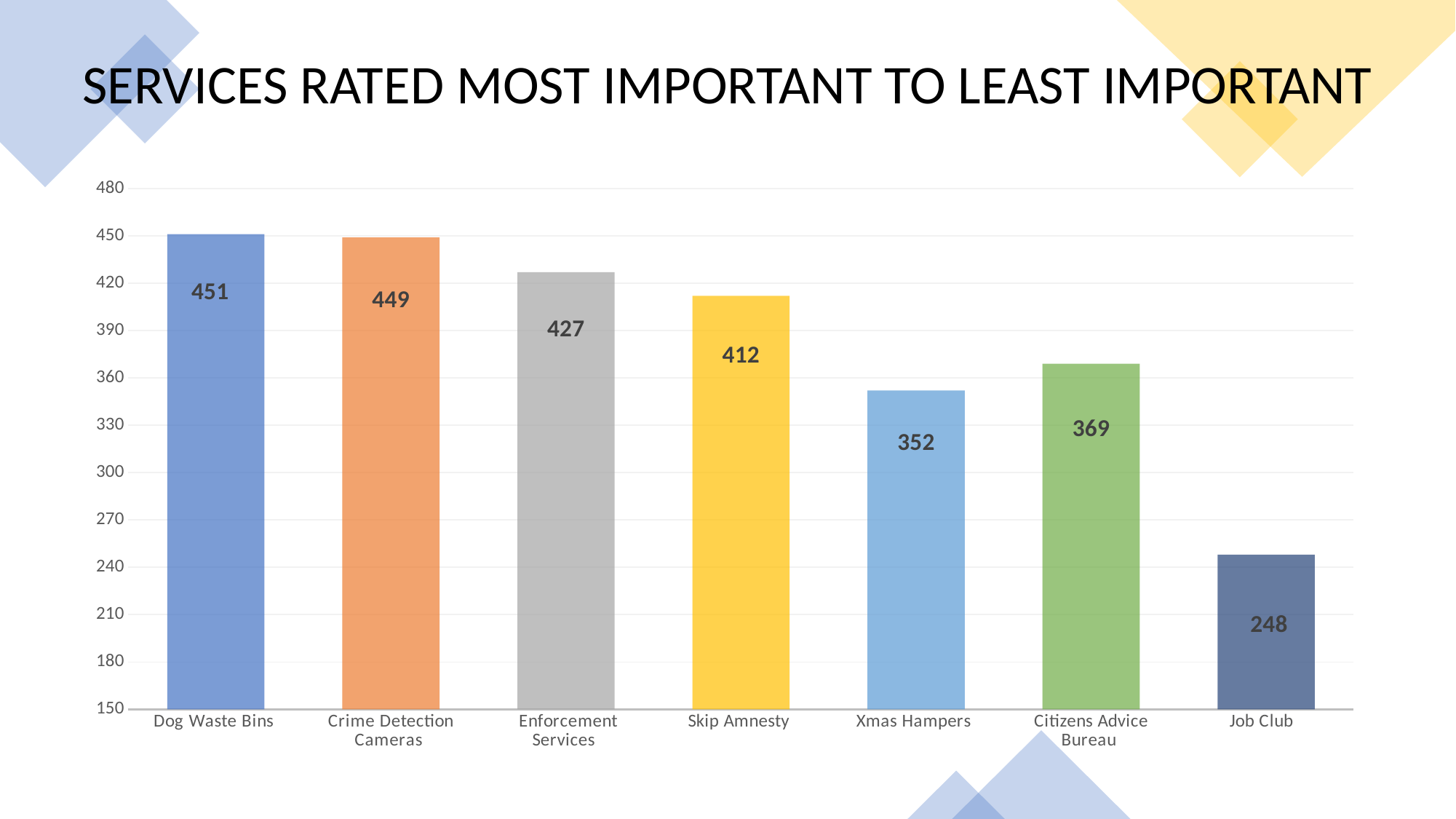
What is the difference between the values for Enforcement Services and Xmas Hampers? 75 Which is larger, the value for Xmas Hampers or the value for Citizens Advice Bureau? Citizens Advice Bureau Which service has the lowest value? Job Club Is the value for Job Club greater or less than 270? less Which service has the highest value? Dog Waste Bins What is the title of the slide? SERVICES RATED MOST IMPORTANT TO LEAST IMPORTANT How many services are shown in the chart? 7 What is the value for Citizens Advice Bureau? 369 What is the value for Dog Waste Bins? 451 What is the value for Skip Amnesty? 412 What kind of chart is shown on the slide? bar chart What is the difference between the values for Dog Waste Bins and Job Club? 203